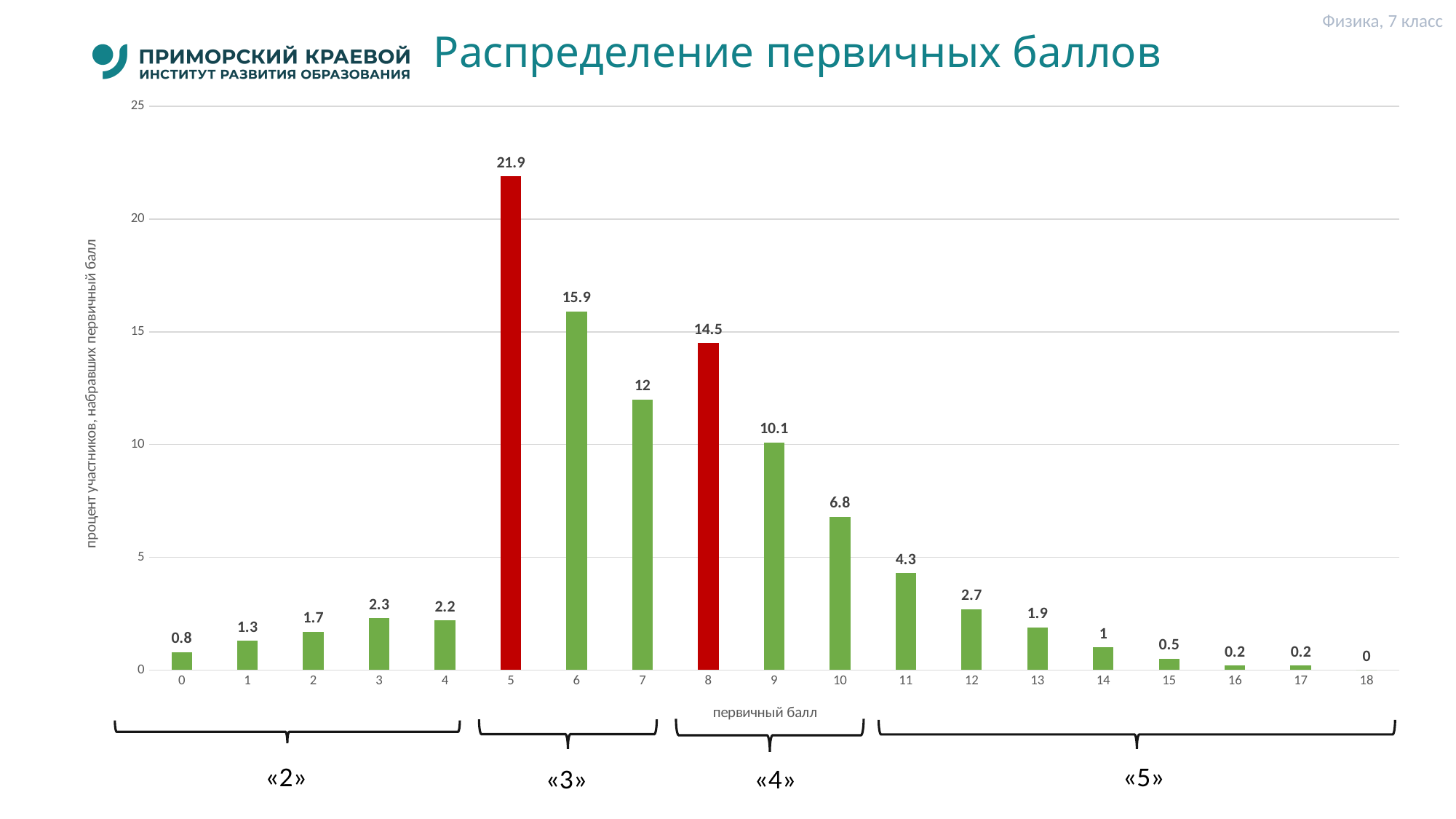
Which primary scores are shown with red bars? 5 and 8 What is the value for primary score 5? 21.9 What kind of chart is shown on the slide? bar chart How many primary score categories are shown on the x axis? 19 What is the value for primary score 8? 14.5 What is the value for primary score 11? 4.3 Which is larger, the value for primary score 9 or primary score 10? 9 What is the difference between the values for primary scores 6 and 7? 3.9 Do the values rise or fall from primary score 8 to primary score 18? fall Which primary score has the lowest percentage of participants? 18 Is the value for primary score 5 greater or less than 20? greater Which primary score has the highest percentage of participants? 5